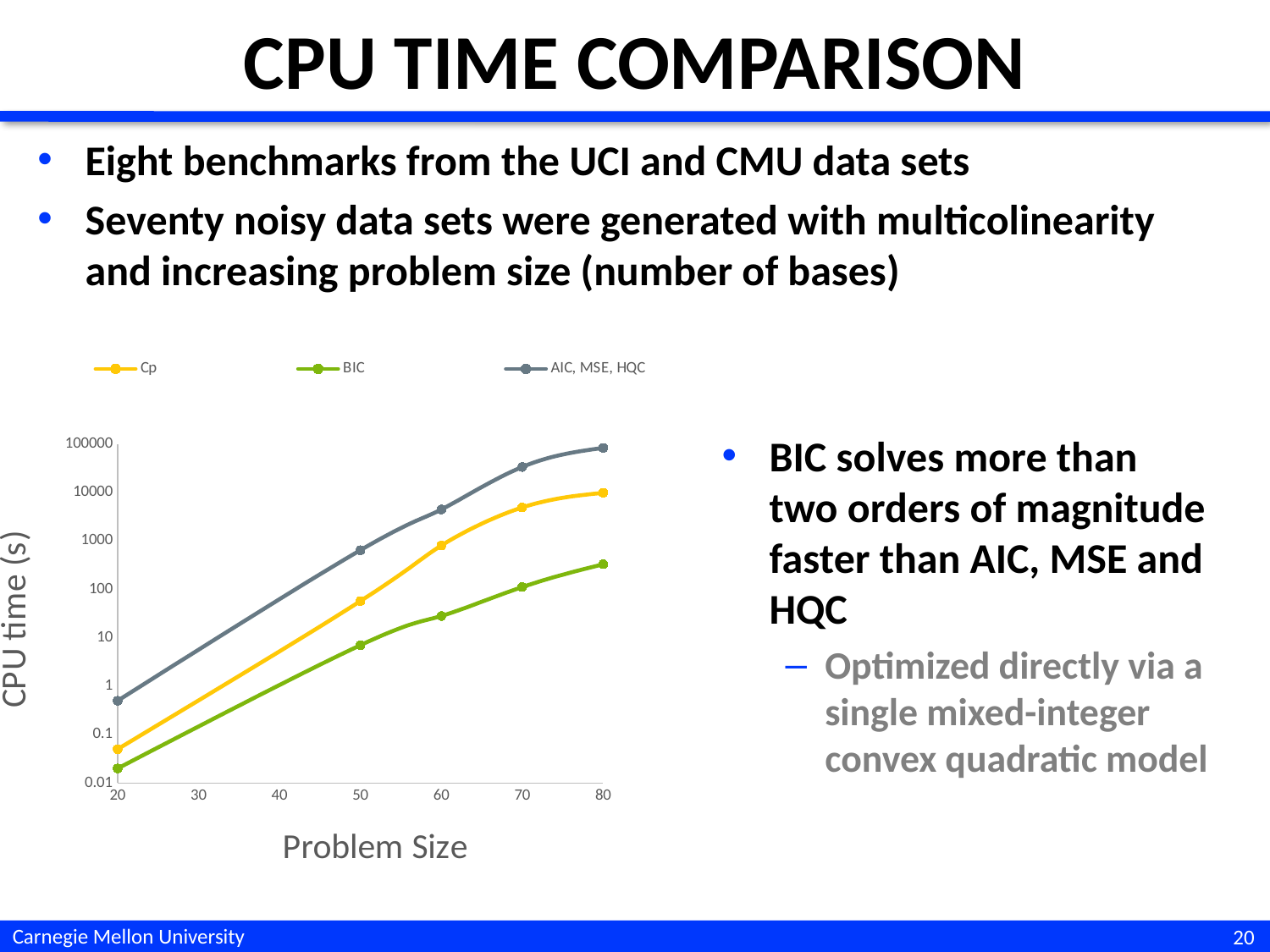
Is the CPU time for BIC at problem size 80 greater or less than 1000? less Is the CPU time for BIC at problem size 20 greater or less than 0.1? less Is the CPU time for AIC, MSE, HQC at problem size 80 greater or less than 10000? greater At problem size 50, which has a larger CPU time, Cp or BIC? Cp What is the label of the x axis of the chart? Problem Size How many data points are plotted for the BIC series? 5 What kind of chart is shown on the slide? line chart Which series has the lowest CPU time at problem size 80? BIC Which series has the highest CPU time at problem size 80? AIC, MSE, HQC How many series does the chart legend list? 3 Does the CPU time for BIC rise or fall as problem size increases? rise Which series are listed in the chart legend? Cp, BIC, AIC, MSE, HQC